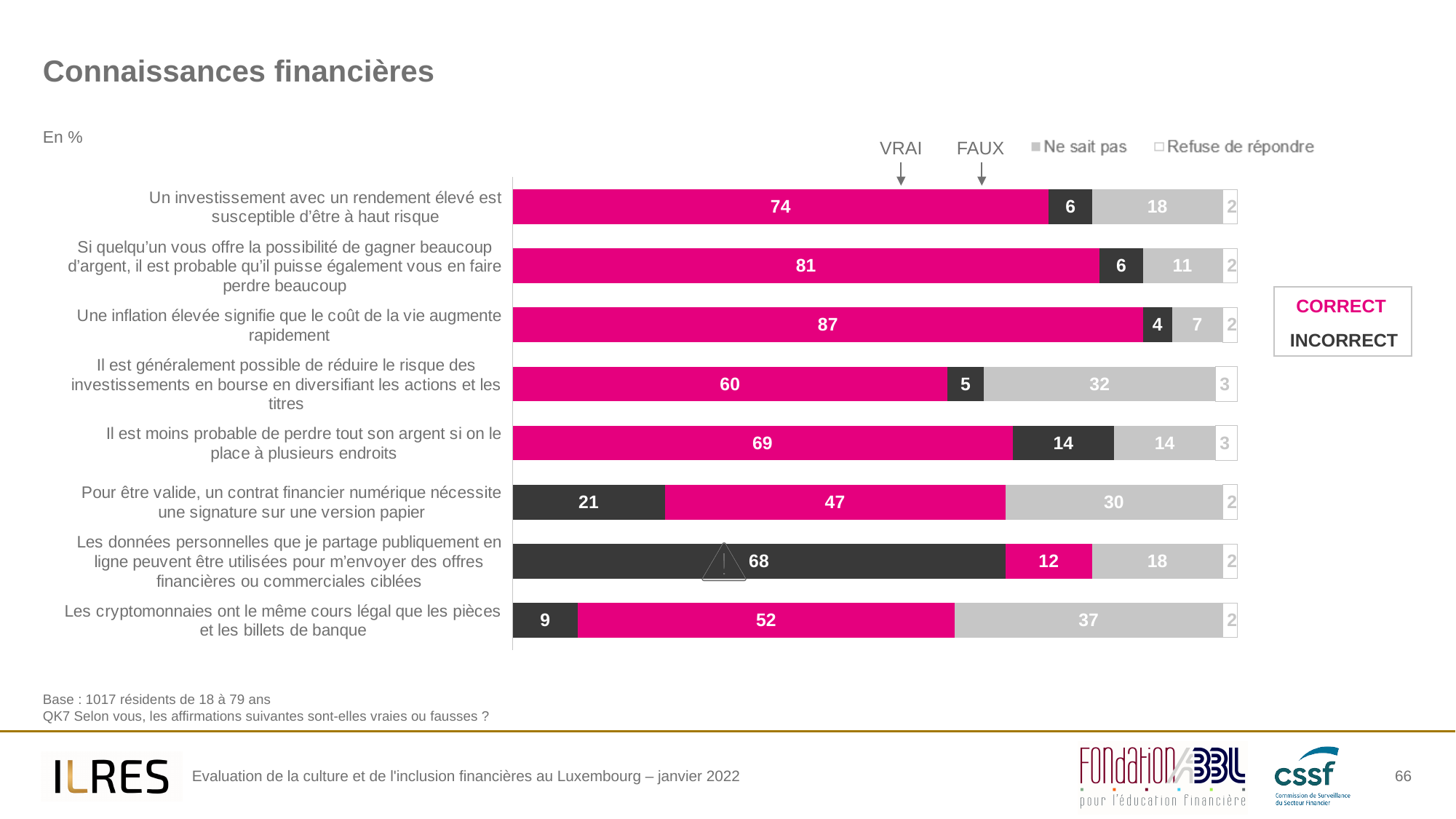
Which is larger: the FAUX value for 'Il est moins probable de perdre tout son argent si on le place à plusieurs endroits' or the FAUX value for 'Un investissement avec un rendement élevé est susceptible d'être à haut risque'? Il est moins probable de perdre tout son argent si on le place à plusieurs endroits Which statement has the lowest 'Ne sait pas' value? Une inflation élevée signifie que le coût de la vie augmente rapidement What percentage answered VRAI to 'Une inflation élevée signifie que le coût de la vie augmente rapidement'? 87 How many statements (categories) are plotted in the chart? 8 What kind of chart is shown on the slide? Stacked bar chart What is the total of the stacked bar for 'Il est généralement possible de réduire le risque des investissements en bourse en diversifiant les actions et les titres'? 100 How many response series does the legend list? 4 What is the 'Refuse de répondre' value for 'Il est moins probable de perdre tout son argent si on le place à plusieurs endroits'? 3 What is the difference between the VRAI values for 'Une inflation élevée signifie que le coût de la vie augmente rapidement' and 'Il est généralement possible de réduire le risque des investissements en bourse en diversifiant les actions et les titres'? 27 What percentage answered FAUX to 'Pour être valide, un contrat financier numérique nécessite une signature sur une version papier'? 47 Which statement has the highest 'Ne sait pas' value? Les cryptomonnaies ont le même cours légal que les pièces et les billets de banque What is the 'Ne sait pas' value for 'Les cryptomonnaies ont le même cours légal que les pièces et les billets de banque'? 37